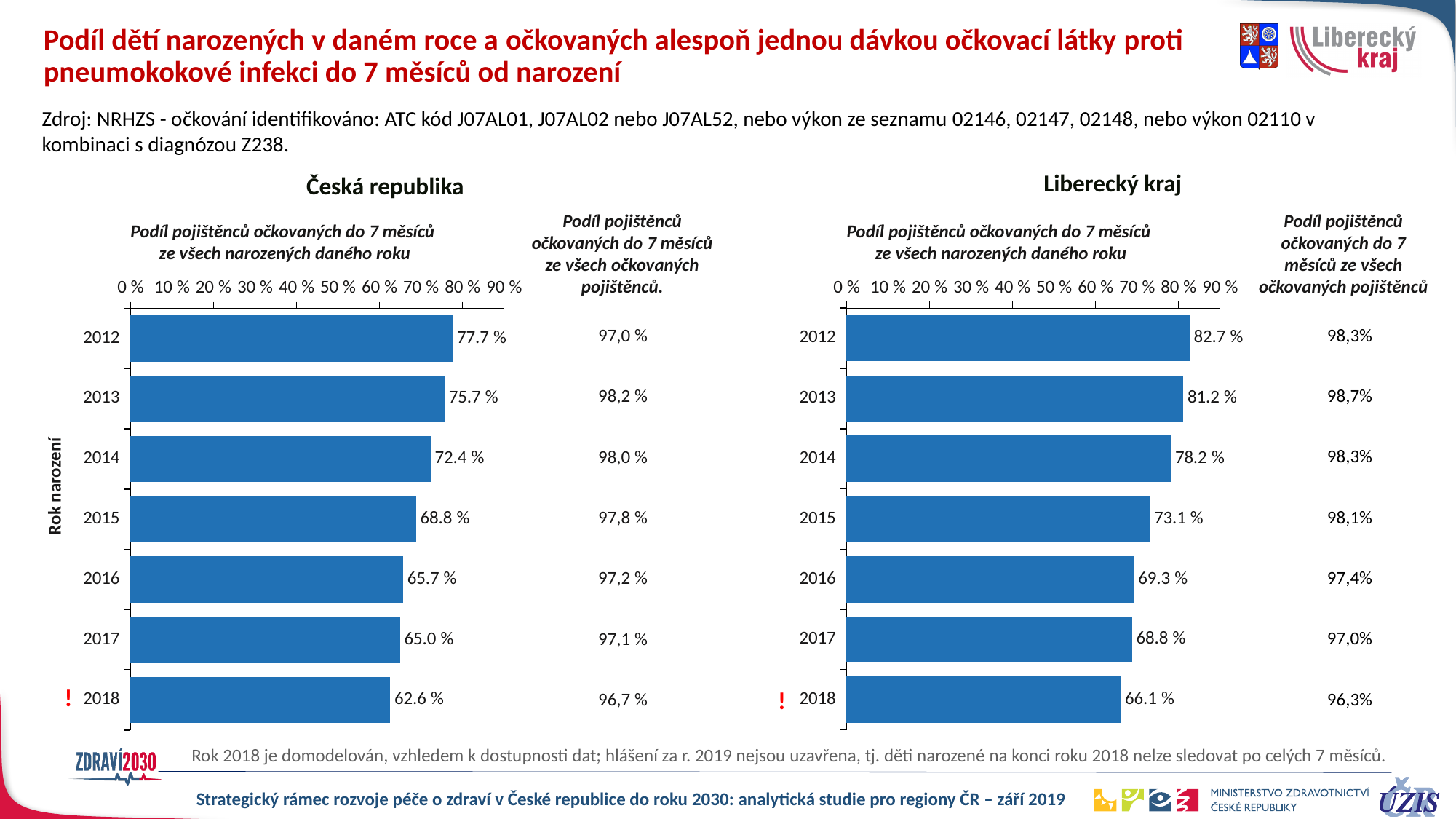
What is the label of the vertical axis in the Česká republika chart? Rok narození How many years are shown in the Česká republika chart? 7 Which is larger: the value for 2012 in the Liberecký kraj chart or the value for 2012 in the Česká republika chart? Liberecký kraj (82.7 %) In the Česká republika chart, do the values rise or fall from 2012 to 2018? fall In the Liberecký kraj chart, which year has the lowest value? 2018 In the Liberecký kraj chart, is the value for 2014 greater or less than 70 %? greater In the Česká republika chart, what is the value for 2012? 77.7 % In the Liberecký kraj chart, what is the value for 2018? 66.1 % In the Česká republika chart, which year has the highest value? 2012 In the Liberecký kraj chart, what is the value for 2015? 73.1 % What kind of chart is the Liberecký kraj chart? bar chart In the Česká republika chart, what is the difference between the values for 2012 and 2018? 15.1 %